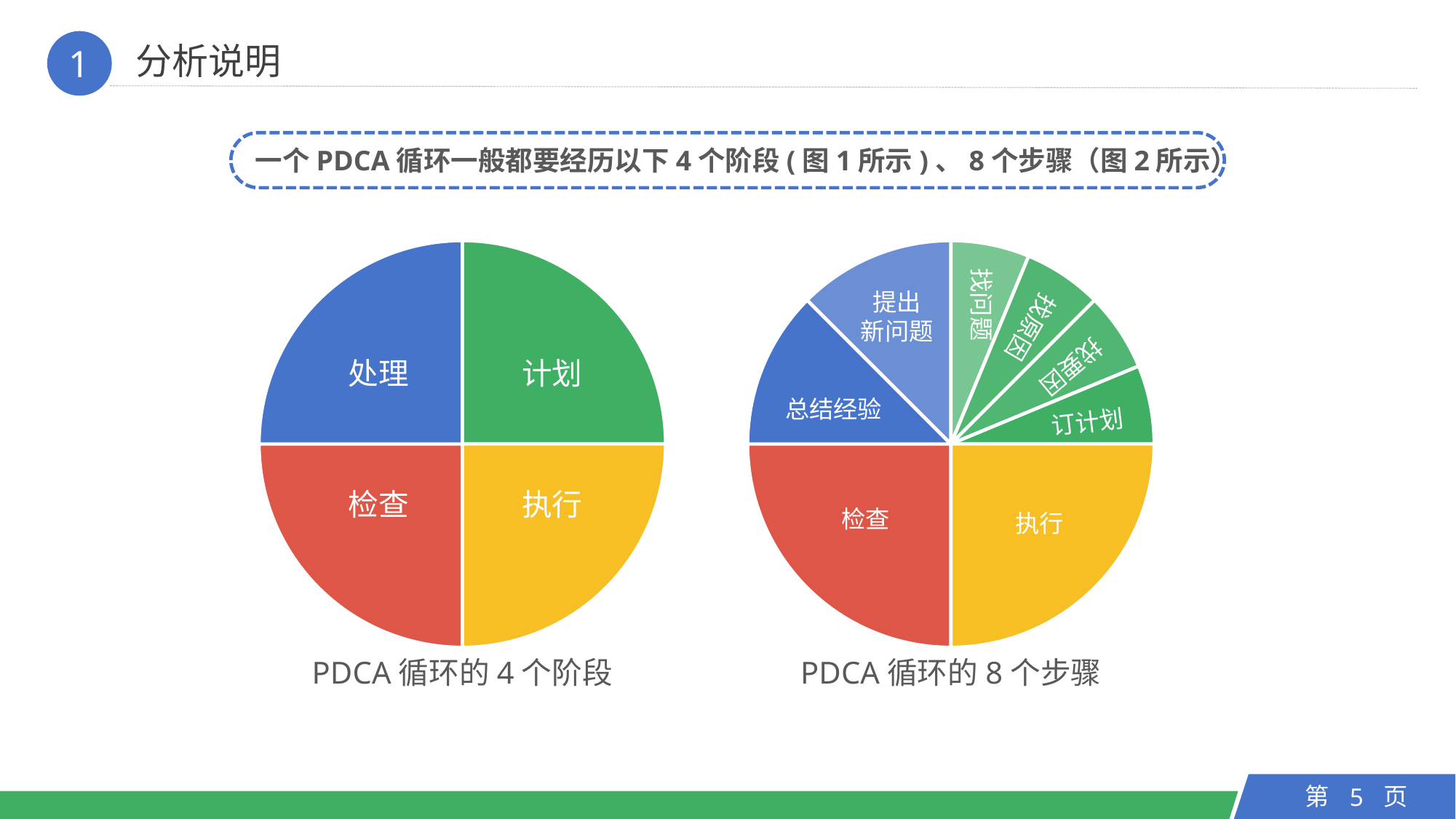
In the chart titled "PDCA 循环的 8 个步骤", which slice is larger, 检查 or 找问题? 检查 How many slices does the chart titled "PDCA 循环的 8 个步骤" have? 8 What kind of chart is the chart titled "PDCA 循环的 4 个阶段"? pie chart In the chart titled "PDCA 循环的 8 个步骤", which slice is larger, 执行 or 订计划? 执行 How many slices does the chart titled "PDCA 循环的 4 个阶段" have? 4 How many pie charts are shown on the slide? 2 What kind of chart is the chart titled "PDCA 循环的 8 个步骤"? pie chart What is the title of the pie chart on the left of the slide? PDCA 循环的 4 个阶段 In the chart titled "PDCA 循环的 8 个步骤", which slice is larger, 总结经验 or 找原因? 总结经验 In the chart titled "PDCA 循环的 4 个阶段", what colour is the 计划 slice? green